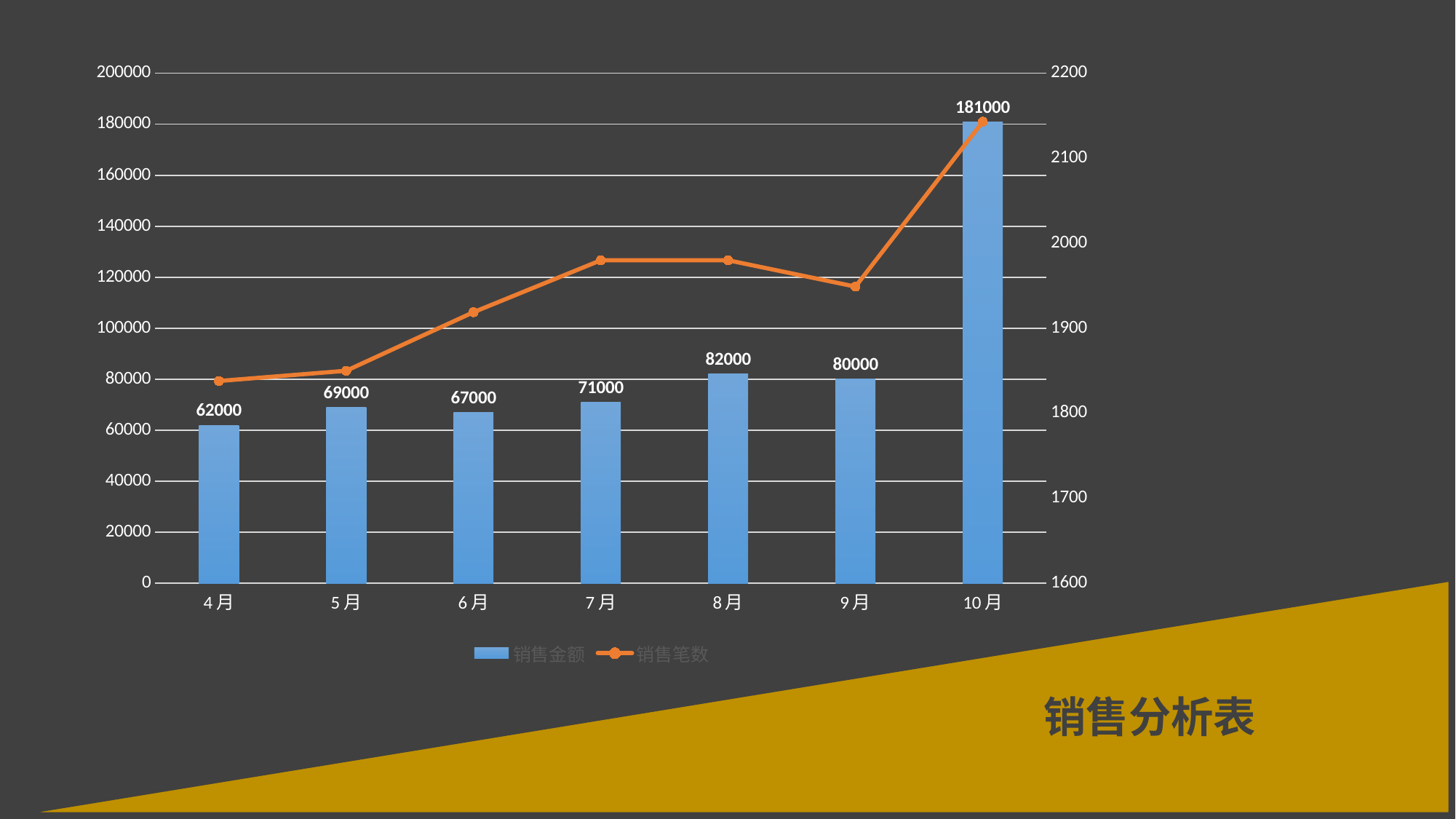
Is the 销售笔数 value for 4月 greater or less than 1900? less How many series does the legend list? 2 What kind of chart is shown on the slide? Combined bar and line chart Which month has the larger 销售金额, 5月 or 6月? 5月 What is the 销售金额 value for 10月? 181000 Which month has the lowest 销售金额? 4月 Is the 销售笔数 value for 10月 greater or less than 2100? greater What is the 销售金额 value for 8月? 82000 Which series is drawn as a line in the chart? 销售笔数 How many months are shown on the x axis? 7 What is the difference in 销售金额 between 10月 and 9月? 101000 Which month has the highest 销售金额? 10月